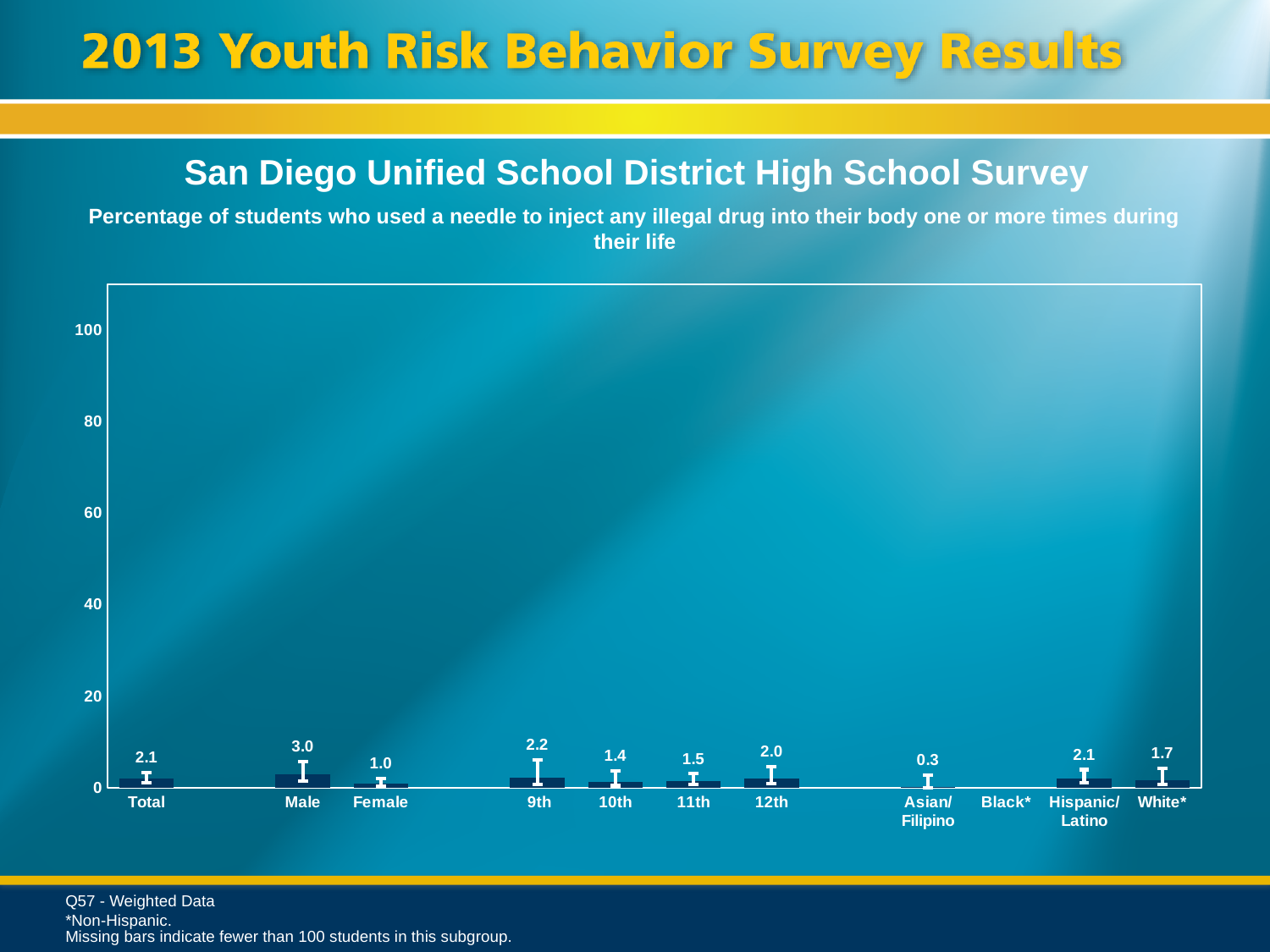
Which category has the highest value? Male What is the value for 9th grade? 2.2 What is the value for Asian/Filipino? 0.3 How many categories are labeled on the x axis? 11 Is the value for Total greater or less than 20? less What is the value for Female? 1.0 Which category has no bar plotted? Black* Which is larger, the value for 12th grade or the value for 10th grade? 12th What is the value for Male? 3.0 What kind of chart is shown? bar chart Which category with a plotted bar has the lowest value? Asian/Filipino What is the difference between the values for Male and Female? 2.0